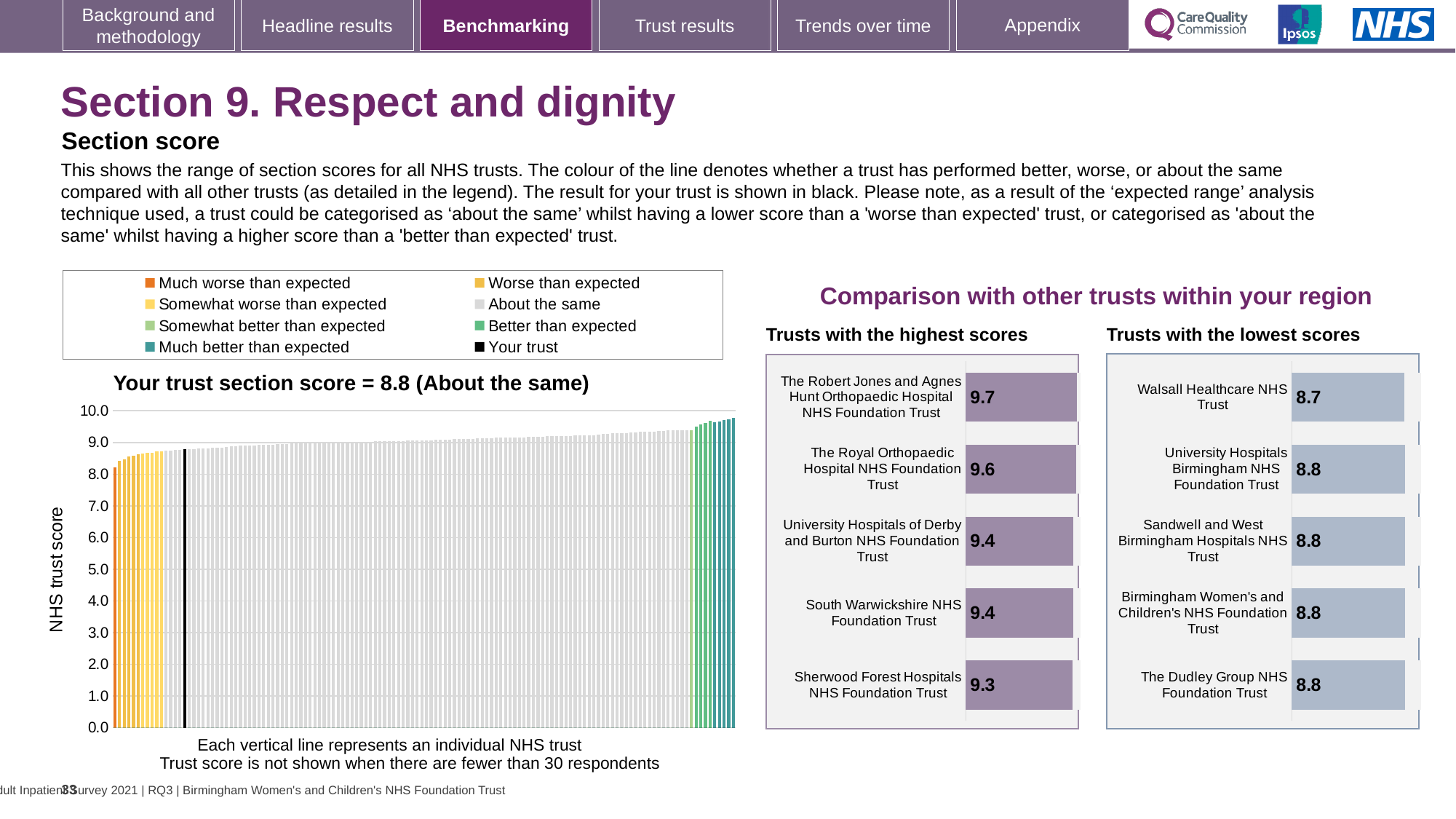
In the 'Trusts with the lowest scores' chart, what is the difference between the scores of The Dudley Group NHS Foundation Trust and Walsall Healthcare NHS Trust? 0.1 In the 'Trusts with the lowest scores' chart, which trust has the lowest score? Walsall Healthcare NHS Trust In the 'Trusts with the highest scores' chart, which trust has the lowest score? Sherwood Forest Hospitals NHS Foundation Trust In the 'Trusts with the highest scores' chart, which has the higher score: The Royal Orthopaedic Hospital NHS Foundation Trust or University Hospitals of Derby and Burton NHS Foundation Trust? The Royal Orthopaedic Hospital NHS Foundation Trust In the 'Trusts with the highest scores' chart, what is the score for The Robert Jones and Agnes Hunt Orthopaedic Hospital NHS Foundation Trust? 9.7 In the 'Trusts with the lowest scores' chart, what is the score for Walsall Healthcare NHS Trust? 8.7 How many trusts are shown in the 'Trusts with the highest scores' chart? 5 What kind of chart is the 'Your trust section score' chart? Bar chart In the 'Your trust section score' chart, do the trust scores rise or fall from left to right? Rise How many entries does the legend above the 'Your trust section score' chart list? 8 In the 'Your trust section score' chart, what is the section score for your trust? 8.8 In the 'Trusts with the highest scores' chart, what is the difference between the scores of The Robert Jones and Agnes Hunt Orthopaedic Hospital NHS Foundation Trust and Sherwood Forest Hospitals NHS Foundation Trust? 0.4